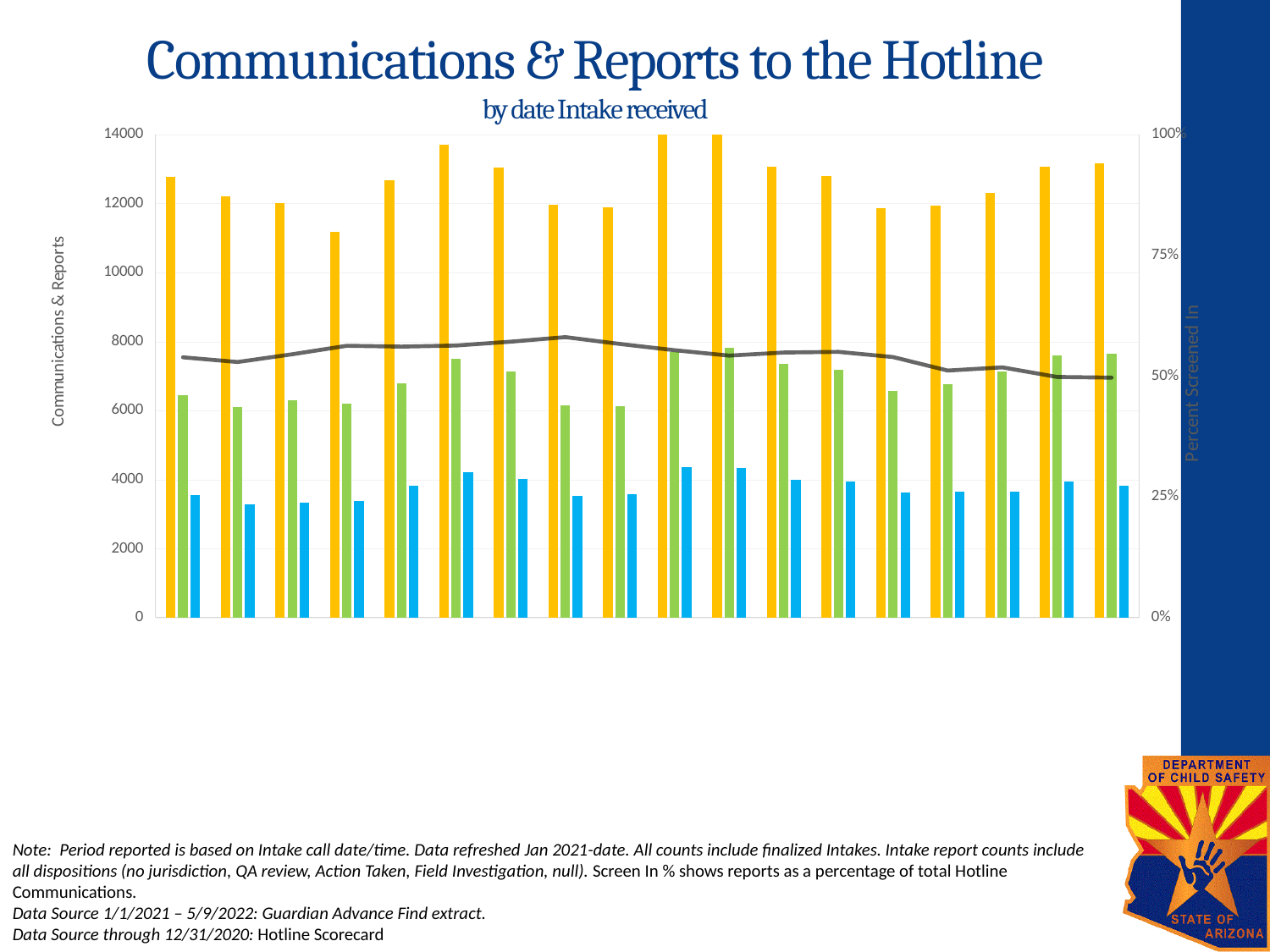
What is the maximum value shown on the left vertical axis? 14000 Does the dark line ever drop below 25% on the right axis? No Which colour of bar is the tallest in every group: yellow, green or blue? Yellow Is the tallest blue bar greater or less than 6000? less What type of chart is shown on the slide? Bar chart with a line Is the tallest yellow bar greater or less than 12000? greater How many groups of bars are plotted along the x axis? 18 What is the subtitle shown under the chart title? by date Intake received How many bars are in each group along the x axis? 3 What is the title of the chart? Communications & Reports to the Hotline